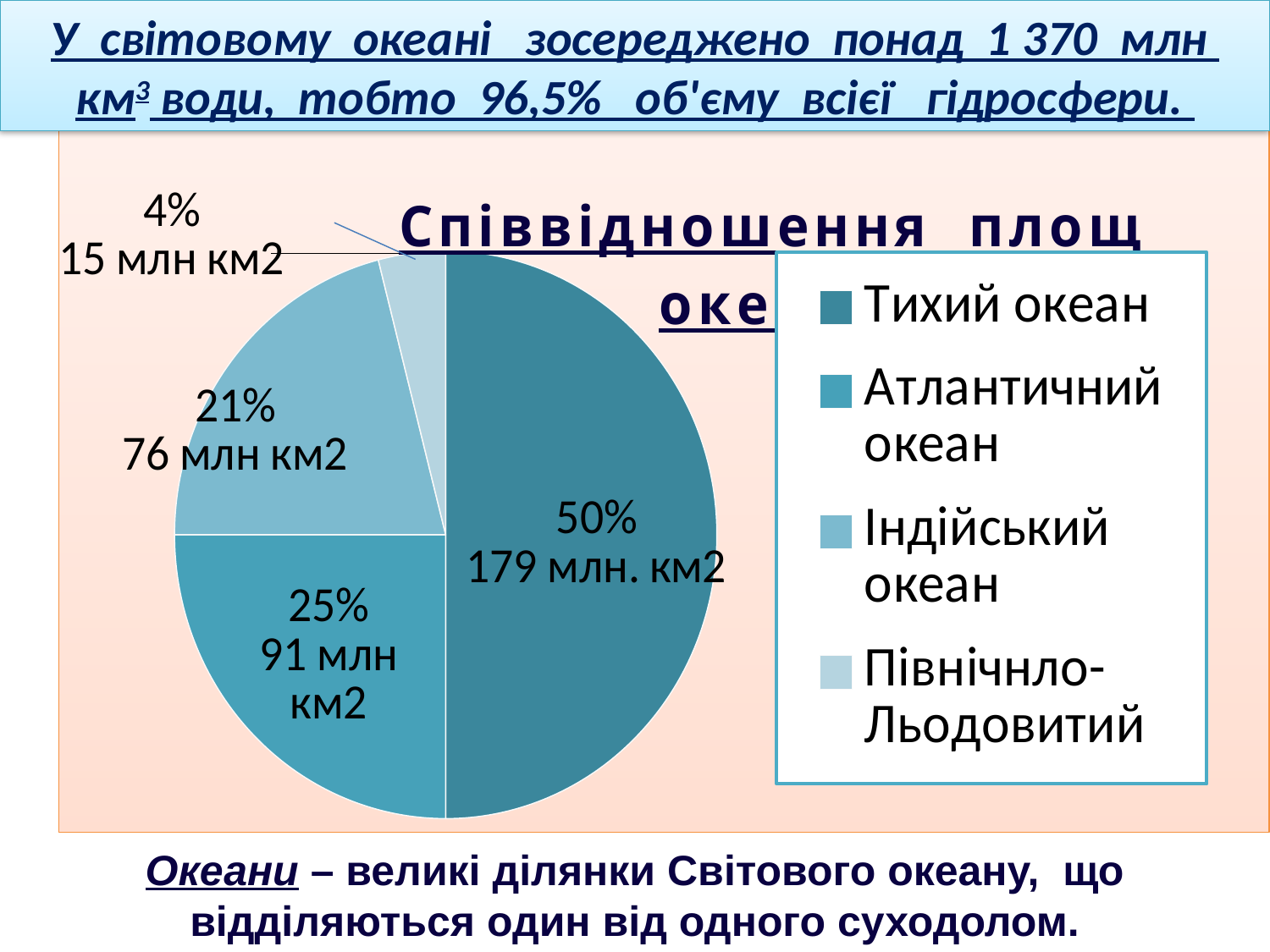
What kind of chart is shown on the slide? pie chart What area value is printed for Атлантичний океан? 91 млн км2 What percentage share of the pie does Тихий океан have? 50% Which is larger, the slice for Атлантичний океан or the slice for Індійський океан? Атлантичний океан How many categories does the legend list? 4 What percentage share is shown for Північнло-Льодовитий? 4% What area value is printed for Індійський океан? 76 млн км2 What area value is printed for Північнло-Льодовитий? 15 млн км2 What area value is printed for Тихий океан? 179 млн. км2 What is the difference in percentage points between the Тихий океан slice and the Атлантичний океан slice? 25% Which ocean has the largest slice of the pie? Тихий океан Which ocean has the smallest slice of the pie? Північнло-Льодовитий